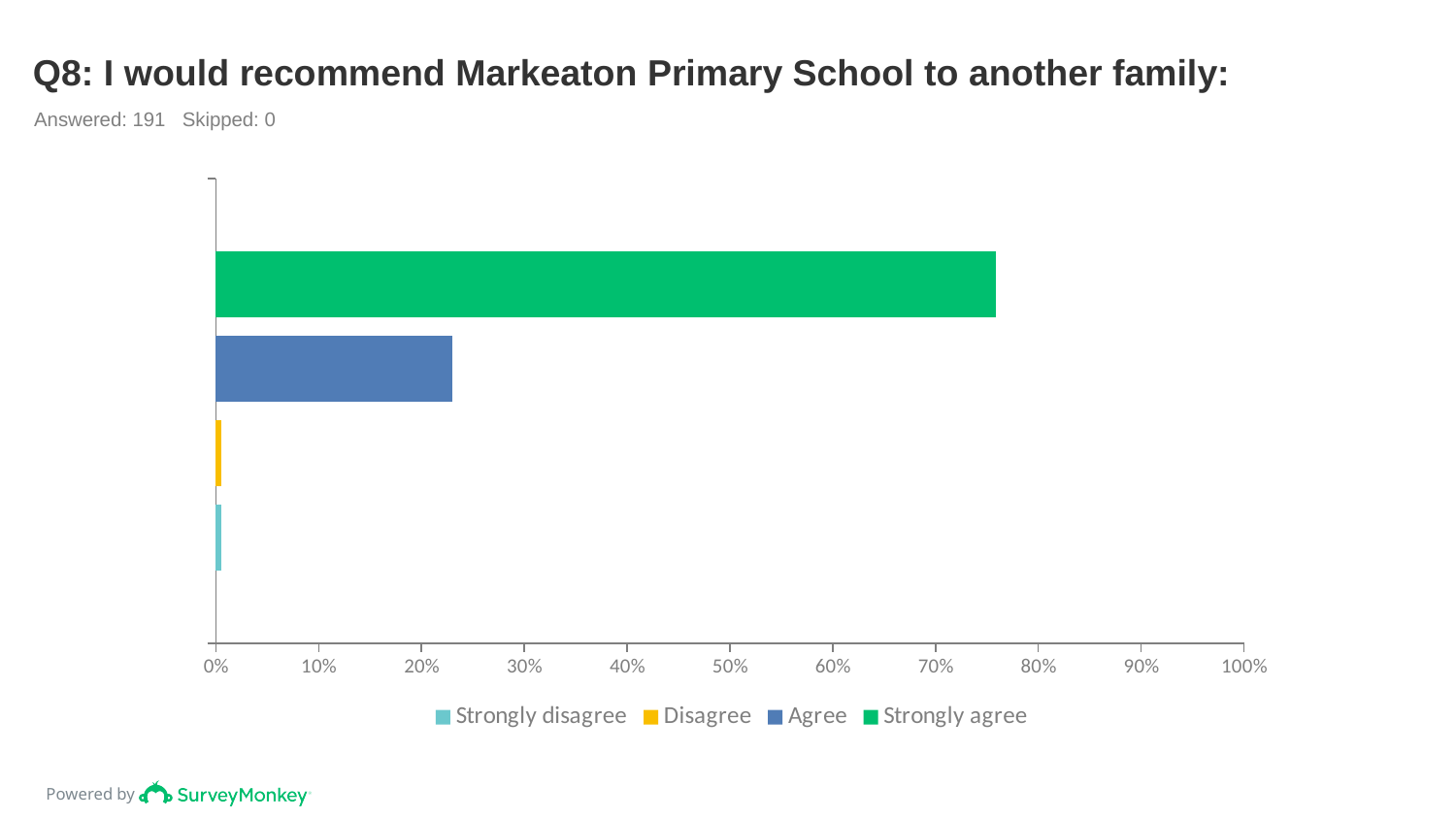
What is the title of the chart? Q8: I would recommend Markeaton Primary School to another family: Is the value for Agree greater or less than 30%? less Which is larger, the value for Agree or the value for Disagree? Agree What kind of chart is shown on the slide? Bar chart Is the value for Strongly agree greater or less than 80%? less Is the value for Agree greater or less than 20%? greater How many series does the legend list? 4 What colour is the bar for Strongly agree? Green Which is larger, the value for Strongly agree or the value for Agree? Strongly agree Which response has the highest value? Strongly agree